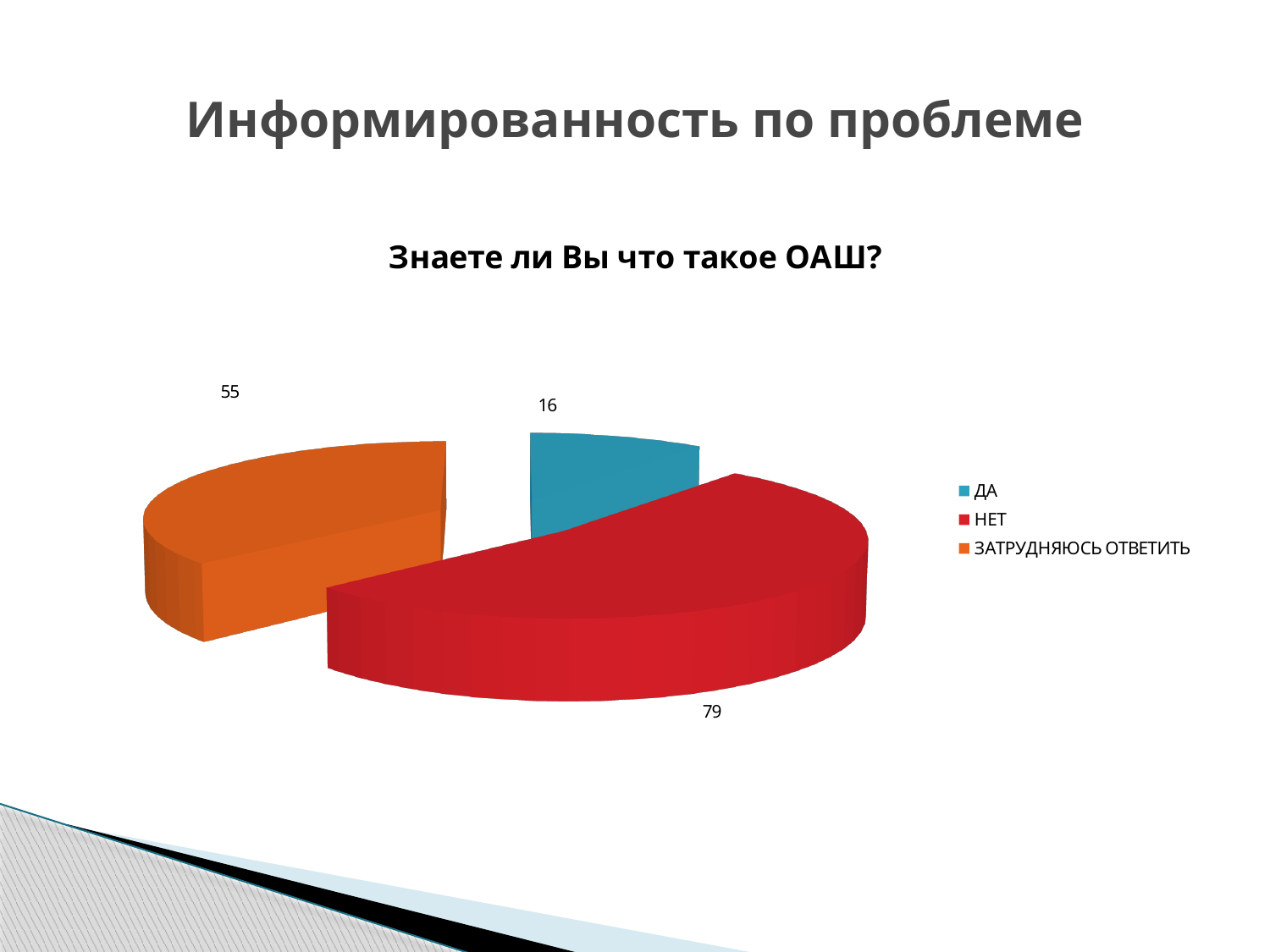
Which colour represents НЕТ in the legend? red How many categories does the pie chart have? 3 What type of chart is shown on the slide? pie chart What is the value for ЗАТРУДНЯЮСЬ ОТВЕТИТЬ? 55 What is the title of the chart? Знаете ли Вы что такое ОАШ? Which category has the smallest slice? ДА What is the difference between the values for НЕТ and ЗАТРУДНЯЮСЬ ОТВЕТИТЬ? 24 Which is larger, the value for ЗАТРУДНЯЮСЬ ОТВЕТИТЬ or the value for ДА? ЗАТРУДНЯЮСЬ ОТВЕТИТЬ What is the difference between the values for НЕТ and ДА? 63 What is the value for ДА? 16 Which category has the largest slice? НЕТ What is the value for НЕТ? 79